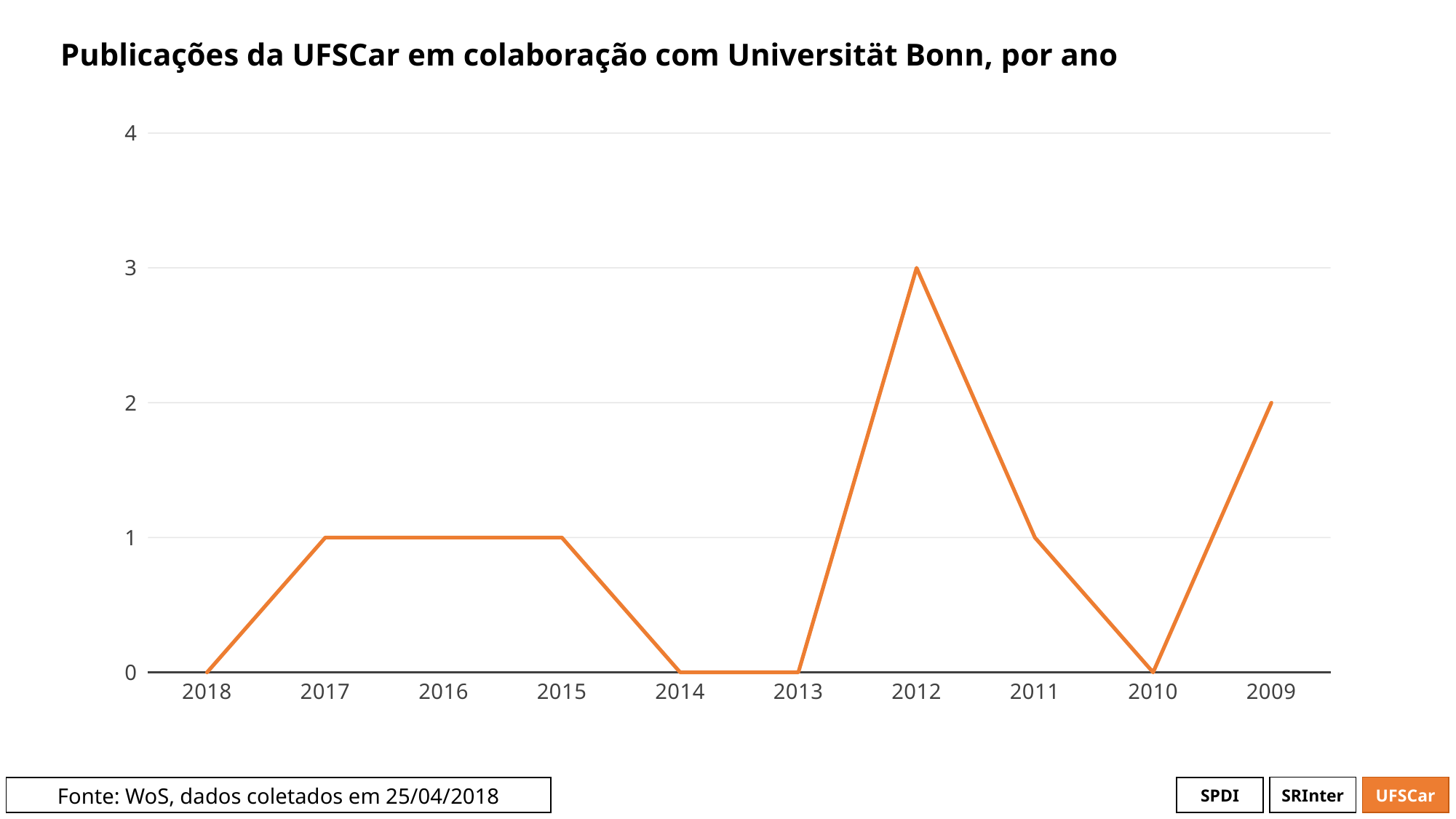
What type of chart is shown on the slide? line chart What is the value for 2012? 3 How many years are plotted on the x axis? 10 What is the difference between the values for 2012 and 2009? 1 Which is larger, the value for 2011 or the value for 2009? 2009 What is the value for 2009? 2 What is the value for 2014? 0 Is the value for 2012 greater or less than 2? greater Do the values rise or fall from 2010 to 2009 along the x axis? rise Which year has the highest value? 2012 What is the value for 2017? 1 What is the title of the chart? Publicações da UFSCar em colaboração com Universität Bonn, por ano